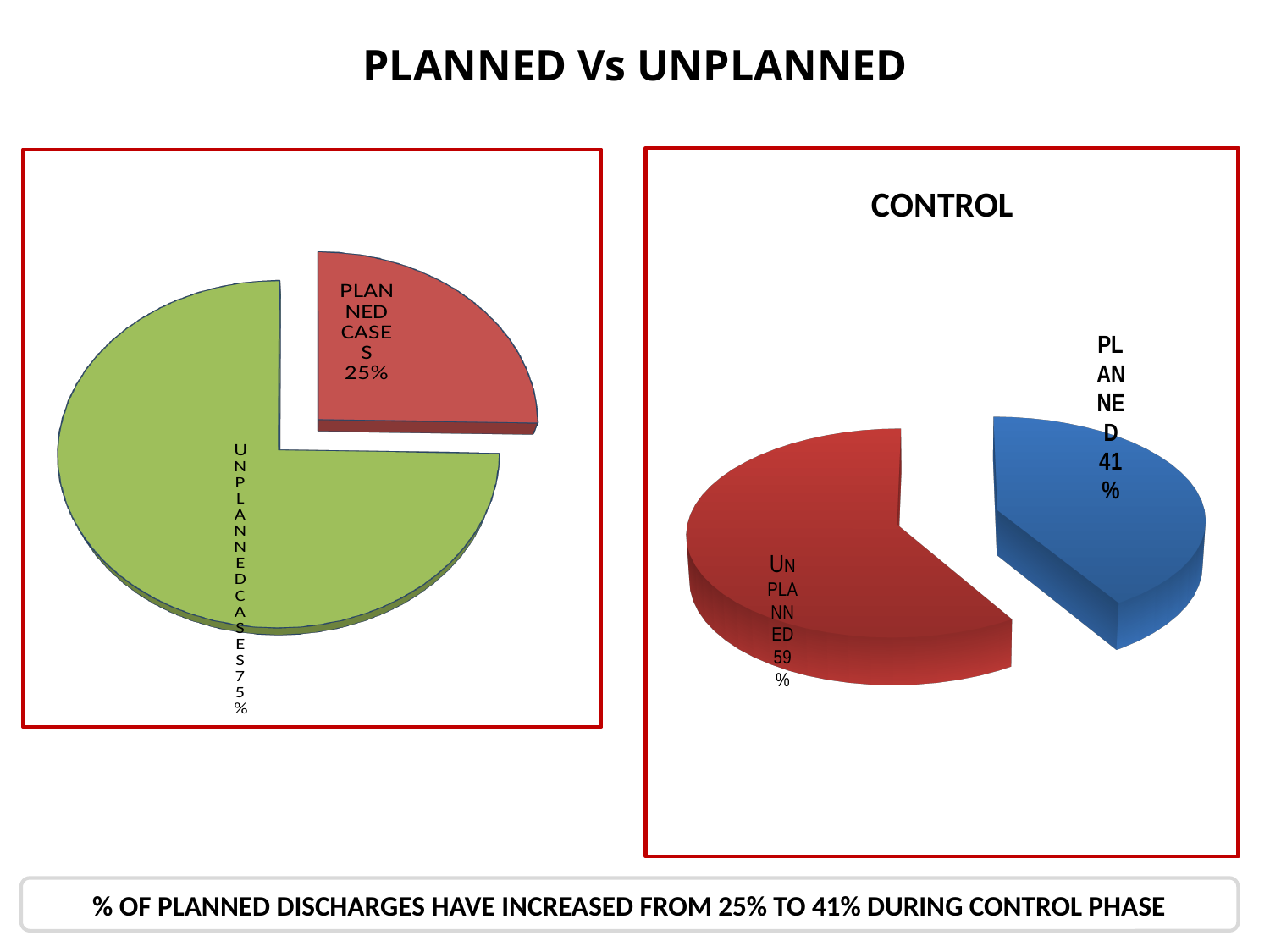
Which is larger: the PLANNED share in the left pie chart or the PLANNED share in the CONTROL pie chart? CONTROL pie chart What is the title of the right-hand chart? CONTROL In the CONTROL pie chart, what share is labelled for PLANNED? 41% In the left pie chart, what share is labelled for PLANNED CASES? 25% What type of chart is the left chart on the slide? Pie chart In the left pie chart, what is the difference between the UNPLANNED CASES and PLANNED CASES shares? 50% In the CONTROL pie chart, which slice is the smallest? PLANNED In the CONTROL pie chart, what is the difference between the UNPLANNED and PLANNED shares? 18% In the left pie chart, which slice is the largest? UNPLANNED CASES In the left pie chart, what share is labelled for UNPLANNED CASES? 75% In the CONTROL pie chart, what share is labelled for UNPLANNED? 59% How many slices does the CONTROL pie chart have? 2